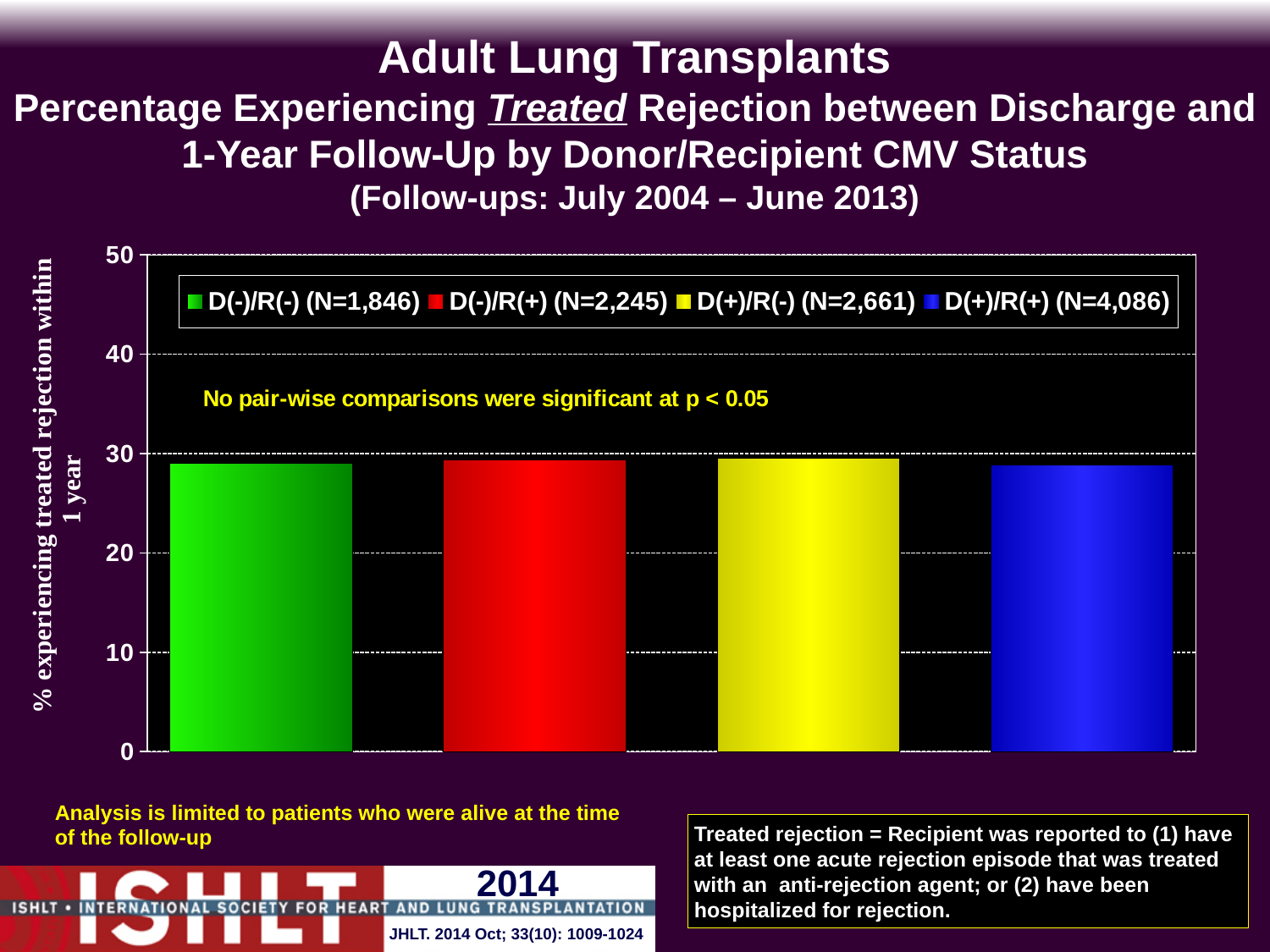
Is the value for D(-)/R(-) greater or less than 20? greater Is the value for D(+)/R(+) greater or less than 40? less How many series does the legend list? 4 What is the label on the y-axis of the chart? % experiencing treated rejection within 1 year How many bars are plotted in the chart? 4 Is the value for D(+)/R(-) greater or less than 40? less What kind of chart is shown on the slide? bar chart What is the sample size (N) shown in the legend for the D(+)/R(+) group? N=4,086